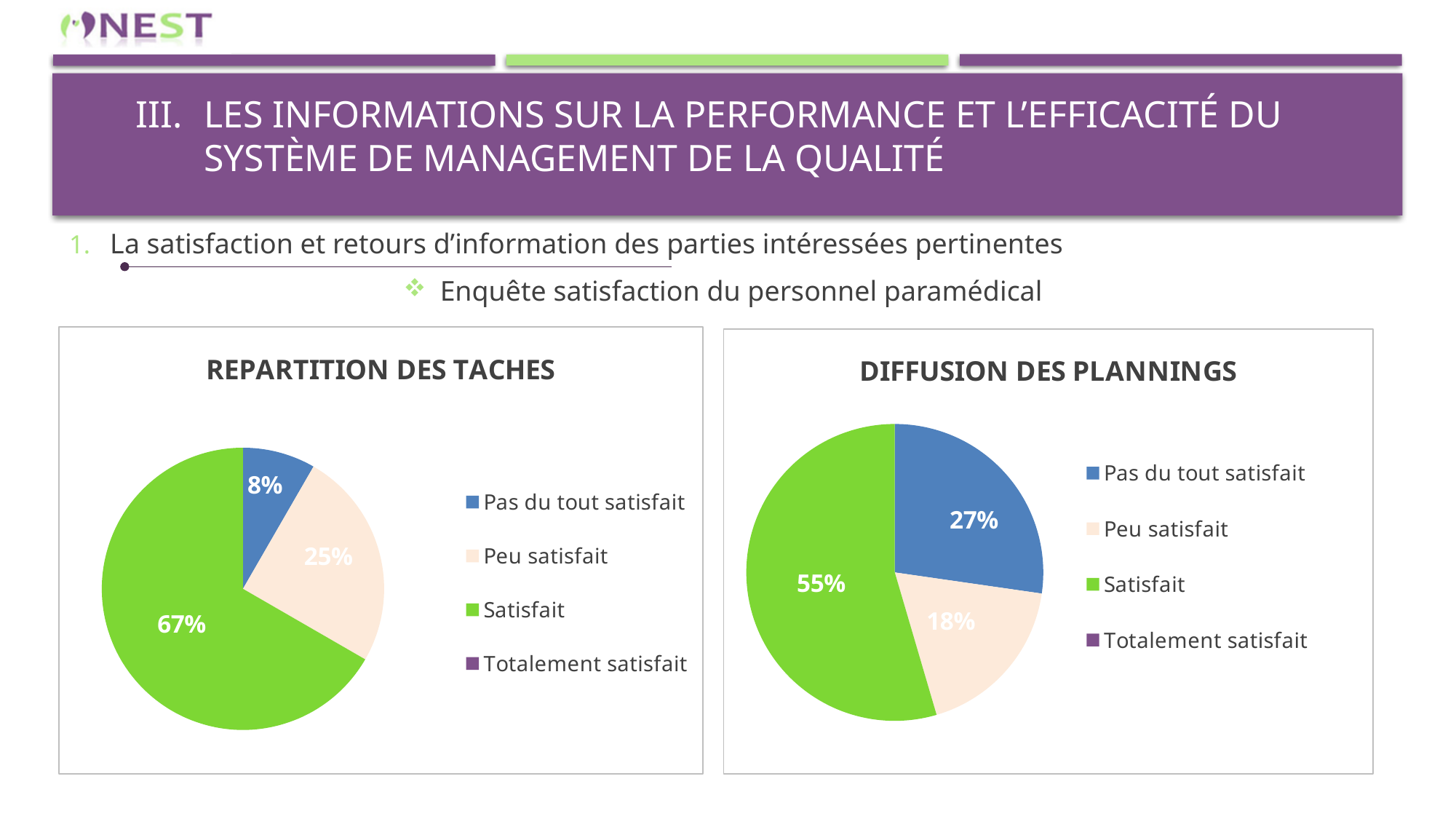
How many entries does the legend of the 'DIFFUSION DES PLANNINGS' chart list? 4 In the 'DIFFUSION DES PLANNINGS' chart, which labelled category has the smallest slice? Peu satisfait In the 'DIFFUSION DES PLANNINGS' chart, what percentage is shown for 'Pas du tout satisfait'? 27% What type of chart is 'REPARTITION DES TACHES'? Pie chart In the 'REPARTITION DES TACHES' chart, what colour is the 'Satisfait' slice? Green In the 'REPARTITION DES TACHES' chart, what is the difference between the 'Satisfait' and 'Peu satisfait' percentages? 42% In the 'REPARTITION DES TACHES' chart, which category has the largest slice? Satisfait In the 'REPARTITION DES TACHES' chart, what percentage is shown for 'Pas du tout satisfait'? 8% In the 'DIFFUSION DES PLANNINGS' chart, which is larger: 'Pas du tout satisfait' or 'Peu satisfait'? Pas du tout satisfait In the 'REPARTITION DES TACHES' chart, what percentage is shown for 'Satisfait'? 67% In the 'DIFFUSION DES PLANNINGS' chart, what percentage is shown for 'Peu satisfait'? 18% In the 'DIFFUSION DES PLANNINGS' chart, what is the difference between the 'Pas du tout satisfait' and 'Peu satisfait' percentages? 9%